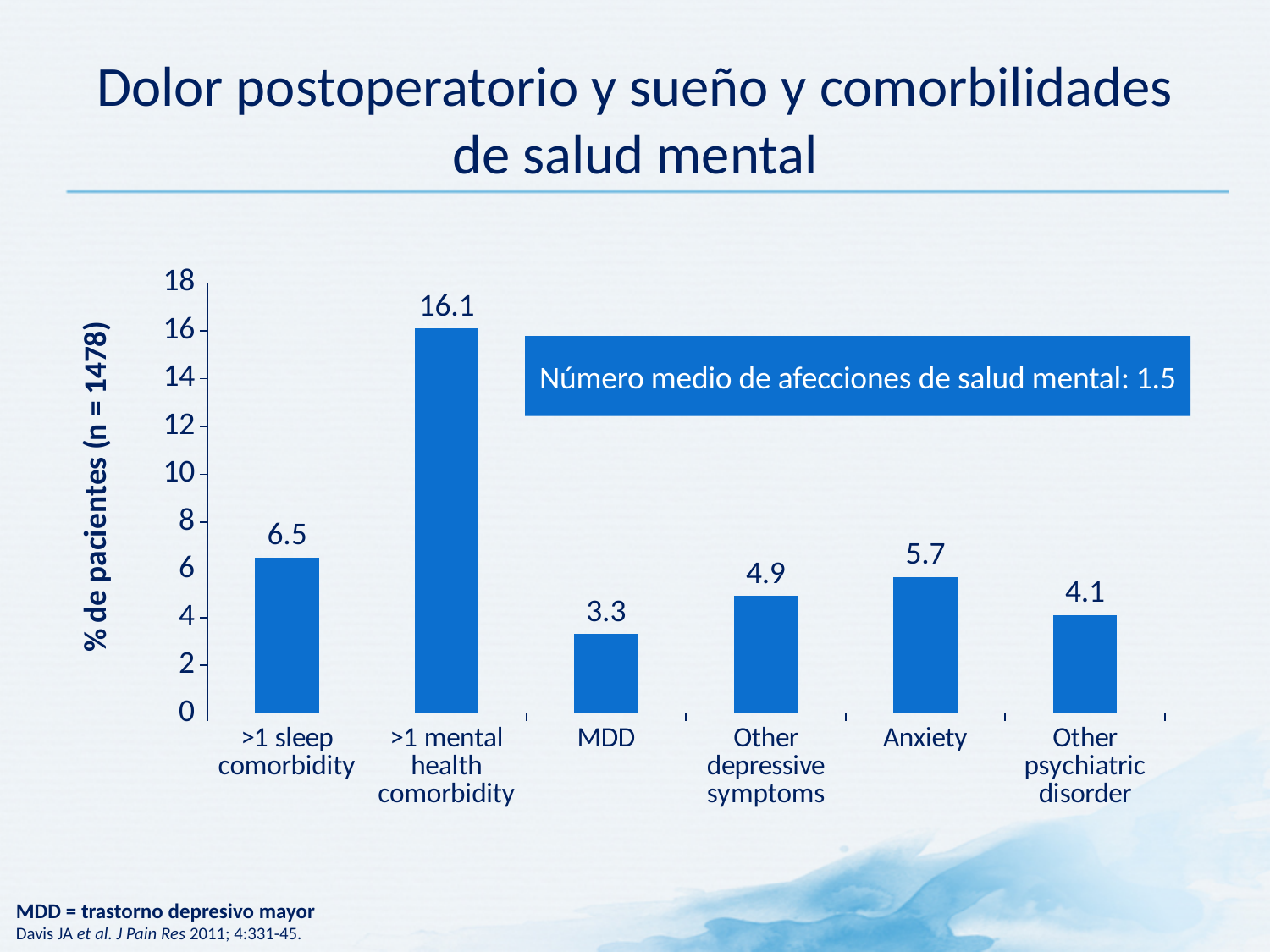
How many categories are shown on the x axis? 6 What is the difference between the values for '>1 mental health comorbidity' and '>1 sleep comorbidity'? 9.6 Is the value for '>1 sleep comorbidity' greater or less than 8? less What is the value for '>1 mental health comorbidity'? 16.1 What kind of chart is shown on the slide? bar chart Which category has the highest value? >1 mental health comorbidity What is the value for 'Anxiety'? 5.7 What is the label of the y axis? % de pacientes (n = 1478) Which is larger, the value for 'Other depressive symptoms' or the value for 'Other psychiatric disorder'? Other depressive symptoms What is the difference between the values for 'Anxiety' and 'Other psychiatric disorder'? 1.6 Which category has the lowest value? MDD What is the value for 'MDD'? 3.3